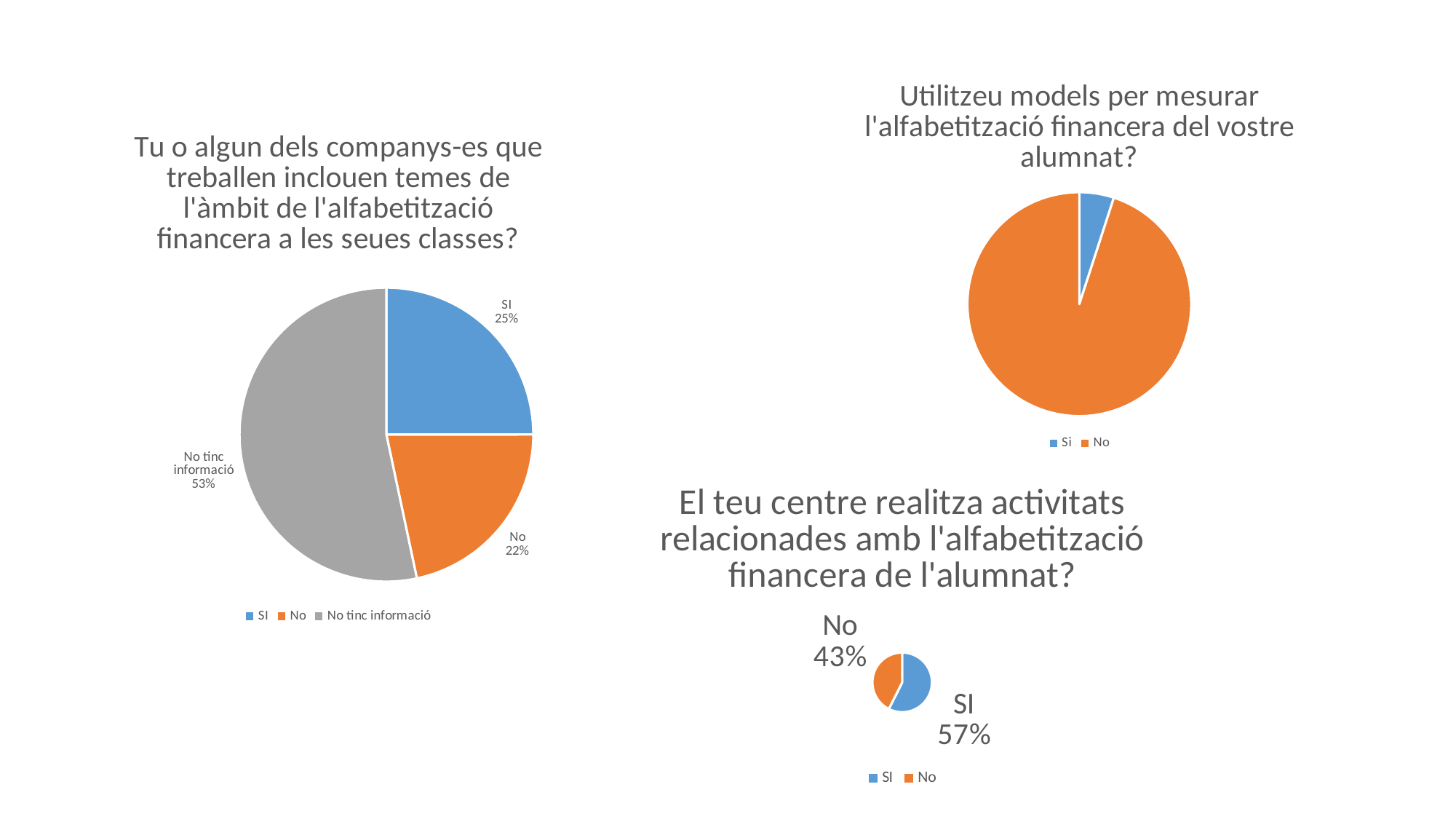
In the chart titled "Tu o algun dels companys-es que treballen inclouen temes de l'àmbit de l'alfabetització financera a les seues classes?", what is the difference between "No tinc informació" and "SI"? 28 percentage points In the chart titled "El teu centre realitza activitats relacionades amb l'alfabetització financera de l'alumnat?", what is the difference between "SI" and "No"? 14 percentage points In the chart titled "Tu o algun dels companys-es que treballen inclouen temes de l'àmbit de l'alfabetització financera a les seues classes?", which category has the smallest slice? No What kind of chart is the one titled "Utilitzeu models per mesurar l'alfabetització financera del vostre alumnat?"? Pie chart How many categories does the legend list in the chart titled "Tu o algun dels companys-es que treballen inclouen temes de l'àmbit de l'alfabetització financera a les seues classes?"? 3 In the chart titled "El teu centre realitza activitats relacionades amb l'alfabetització financera de l'alumnat?", what colour is the "No" slice? Orange In the chart titled "Utilitzeu models per mesurar l'alfabetització financera del vostre alumnat?", which category has the larger slice, "Si" or "No"? No In the chart titled "Tu o algun dels companys-es que treballen inclouen temes de l'àmbit de l'alfabetització financera a les seues classes?", what is the value for "SI"? 25% In the chart titled "Tu o algun dels companys-es que treballen inclouen temes de l'àmbit de l'alfabetització financera a les seues classes?", what share does "No tinc informació" have? 53% In the chart titled "Tu o algun dels companys-es que treballen inclouen temes de l'àmbit de l'alfabetització financera a les seues classes?", what is the value for "No"? 22% In the chart titled "El teu centre realitza activitats relacionades amb l'alfabetització financera de l'alumnat?", what is the value for "SI"? 57% In the chart titled "Tu o algun dels companys-es que treballen inclouen temes de l'àmbit de l'alfabetització financera a les seues classes?", which category has the largest slice? No tinc informació